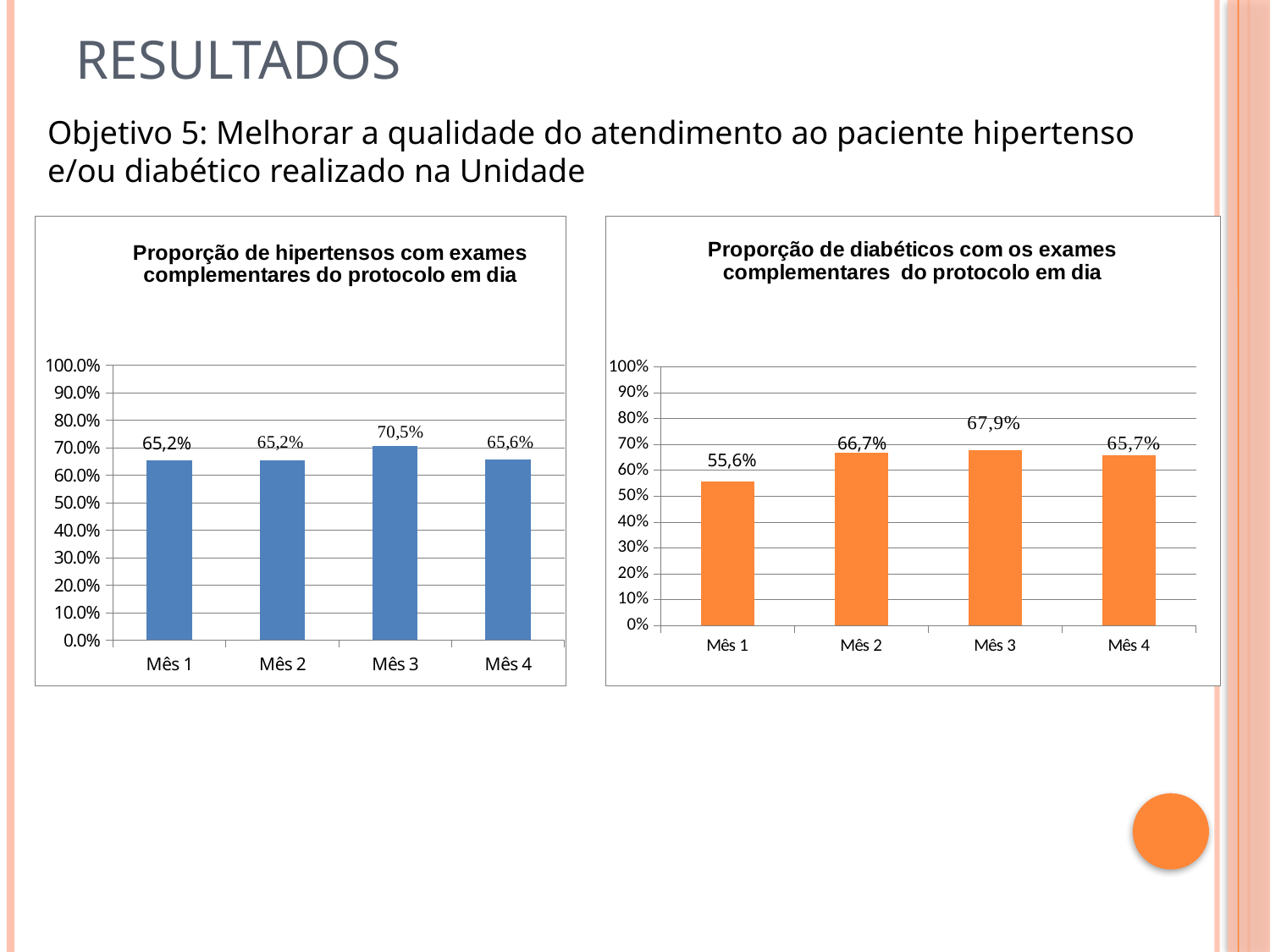
In the left chart (Proporção de hipertensos com exames complementares do protocolo em dia), what is the difference between Mês 3 and Mês 4? 4,9% In the right chart (Proporção de diabéticos com os exames complementares do protocolo em dia), which month has the highest value? Mês 3 In the right chart (Proporção de diabéticos com os exames complementares do protocolo em dia), what is the value for Mês 2? 66,7% In the right chart (Proporção de diabéticos com os exames complementares do protocolo em dia), is the value for Mês 1 greater or less than 60%? less In the right chart (Proporção de diabéticos com os exames complementares do protocolo em dia), which month has the lowest value? Mês 1 What kind of chart is the right chart (Proporção de diabéticos com os exames complementares do protocolo em dia)? Bar chart In the left chart (Proporção de hipertensos com exames complementares do protocolo em dia), which month has the highest value? Mês 3 In the left chart (Proporção de hipertensos com exames complementares do protocolo em dia), how many months are plotted? 4 In the left chart (Proporção de hipertensos com exames complementares do protocolo em dia), what is the value for Mês 4? 65,6% In the left chart (Proporção de hipertensos com exames complementares do protocolo em dia), what is the value for Mês 3? 70,5% In the right chart (Proporção de diabéticos com os exames complementares do protocolo em dia), what is the difference between Mês 3 and Mês 1? 12,3% In the right chart (Proporção de diabéticos com os exames complementares do protocolo em dia), what is the value for Mês 1? 55,6%